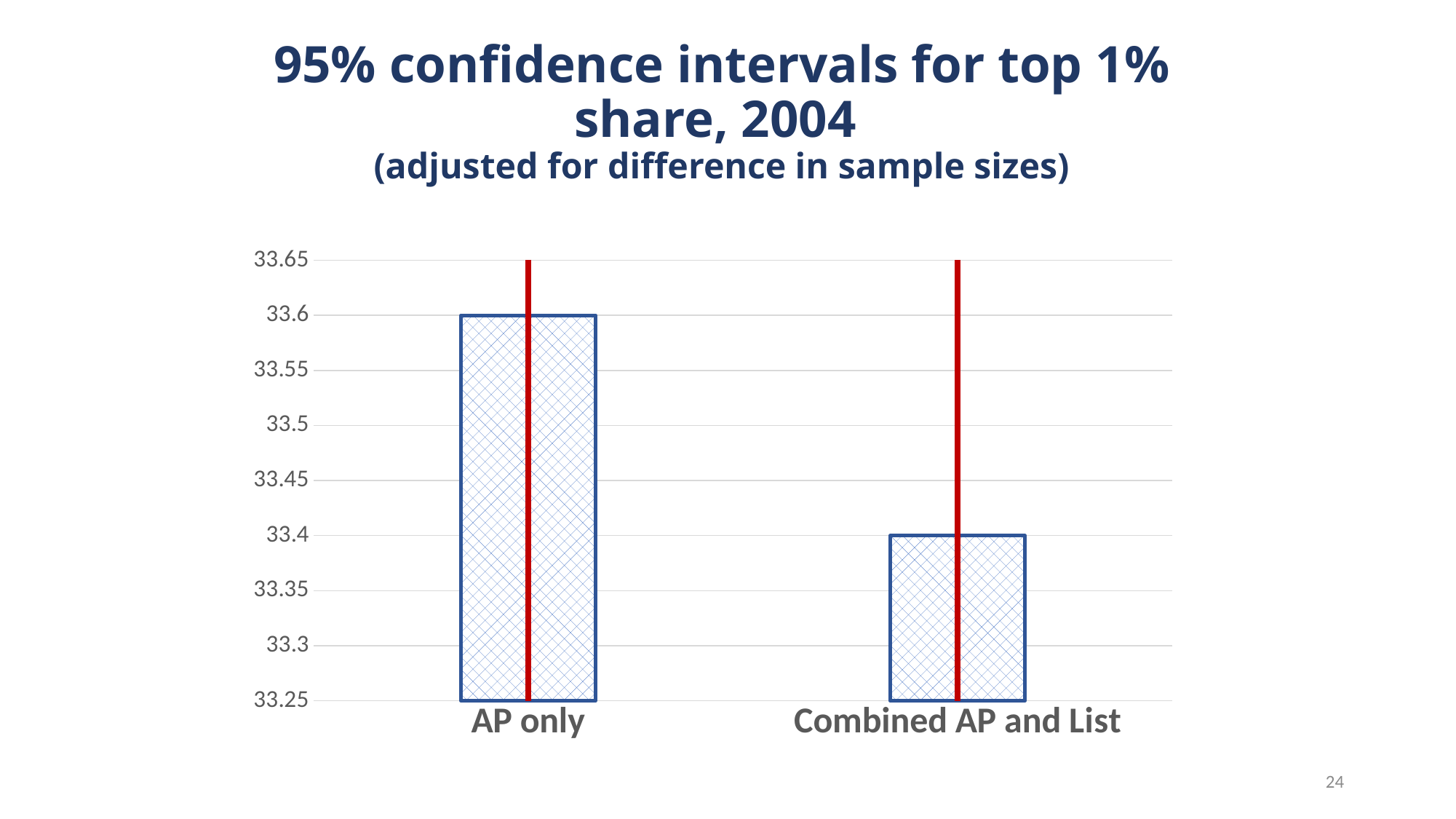
Is the value for Combined AP and List greater or less than 33.5? less Which category has the highest value? AP only What is the difference between the values for AP only and Combined AP and List? 0.2 What is the value for AP only? 33.6 What is the title of the chart? 95% confidence intervals for top 1% share, 2004 (adjusted for difference in sample sizes) Which category has the lowest value? Combined AP and List Which is larger, the value for AP only or the value for Combined AP and List? AP only Is the value for AP only greater or less than 33.5? greater What is the lowest value shown on the y axis? 33.25 What is the value for Combined AP and List? 33.4 What kind of chart is shown on the slide? bar chart How many categories are shown on the x axis? 2